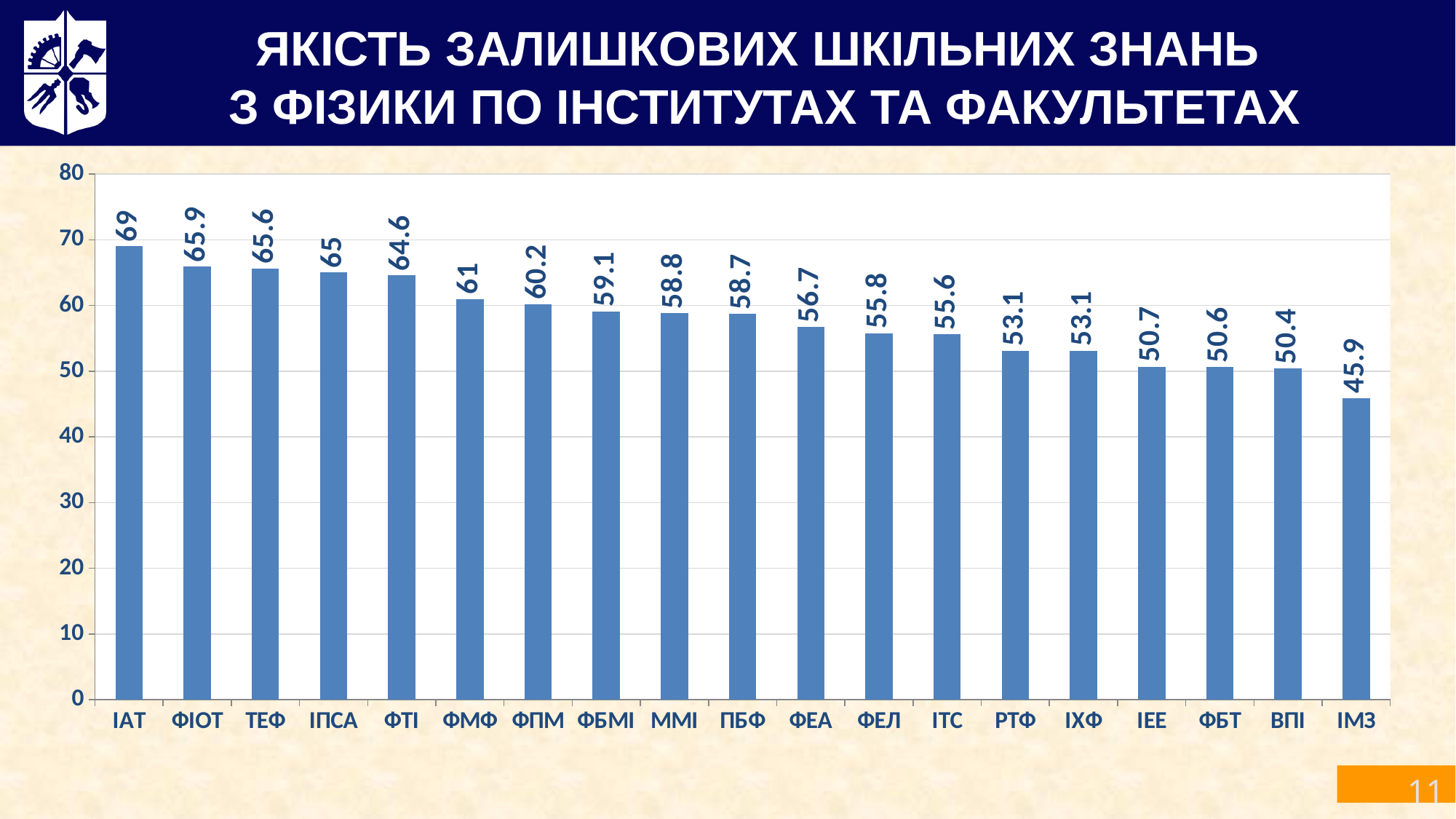
What is the value for ФЕА? 56.7 Which is larger, the value for ФТІ or the value for ФПМ? ФТІ Do the values generally rise or fall from left to right along the x axis? Fall What is the value for ІАТ? 69 What is the value for ФМФ? 61 What is the difference between the values for ІАТ and ІМЗ? 23.1 Which category has the lowest value? ІМЗ What kind of chart is shown on the slide? Bar chart What is the value for ІМЗ? 45.9 How many categories are shown on the x axis? 19 What is the difference between the values for ФІОТ and ФМФ? 4.9 Which category has the highest value? ІАТ